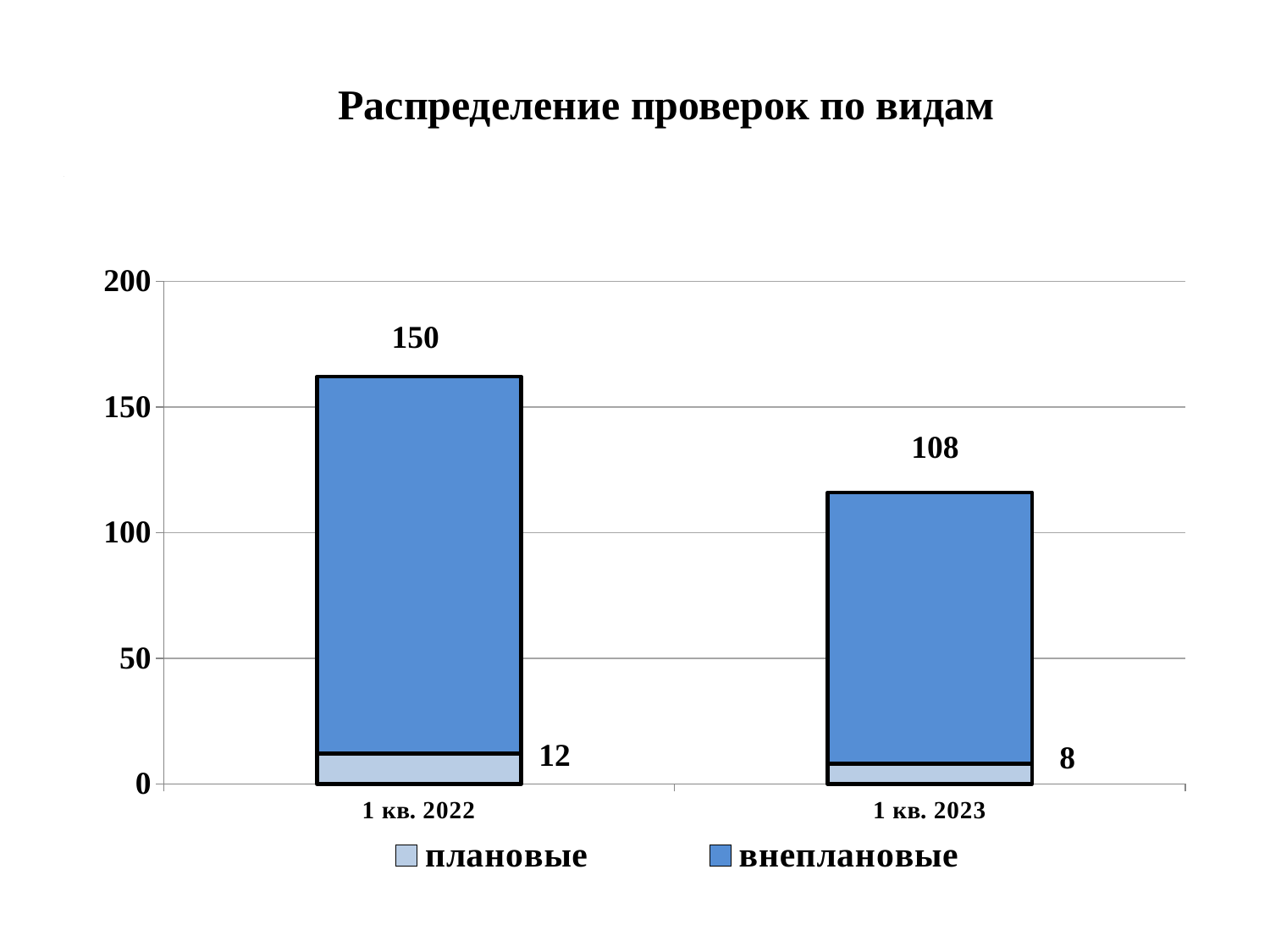
What is the value for внеплановые in 1 кв. 2023? 108 What is the total of the stacked bar for 1 кв. 2023? 116 What is the value for плановые in 1 кв. 2023? 8 What is the value for плановые in 1 кв. 2022? 12 What is the title of the chart? Распределение проверок по видам What is the value for внеплановые in 1 кв. 2022? 150 What kind of chart is shown on the slide? Stacked bar chart What is the difference between the внеплановые values for 1 кв. 2022 and 1 кв. 2023? 42 What is the total of the stacked bar for 1 кв. 2022? 162 How many series does the legend list? 2 Which period has the higher value for внеплановые? 1 кв. 2022 Which period has the lower value for плановые? 1 кв. 2023